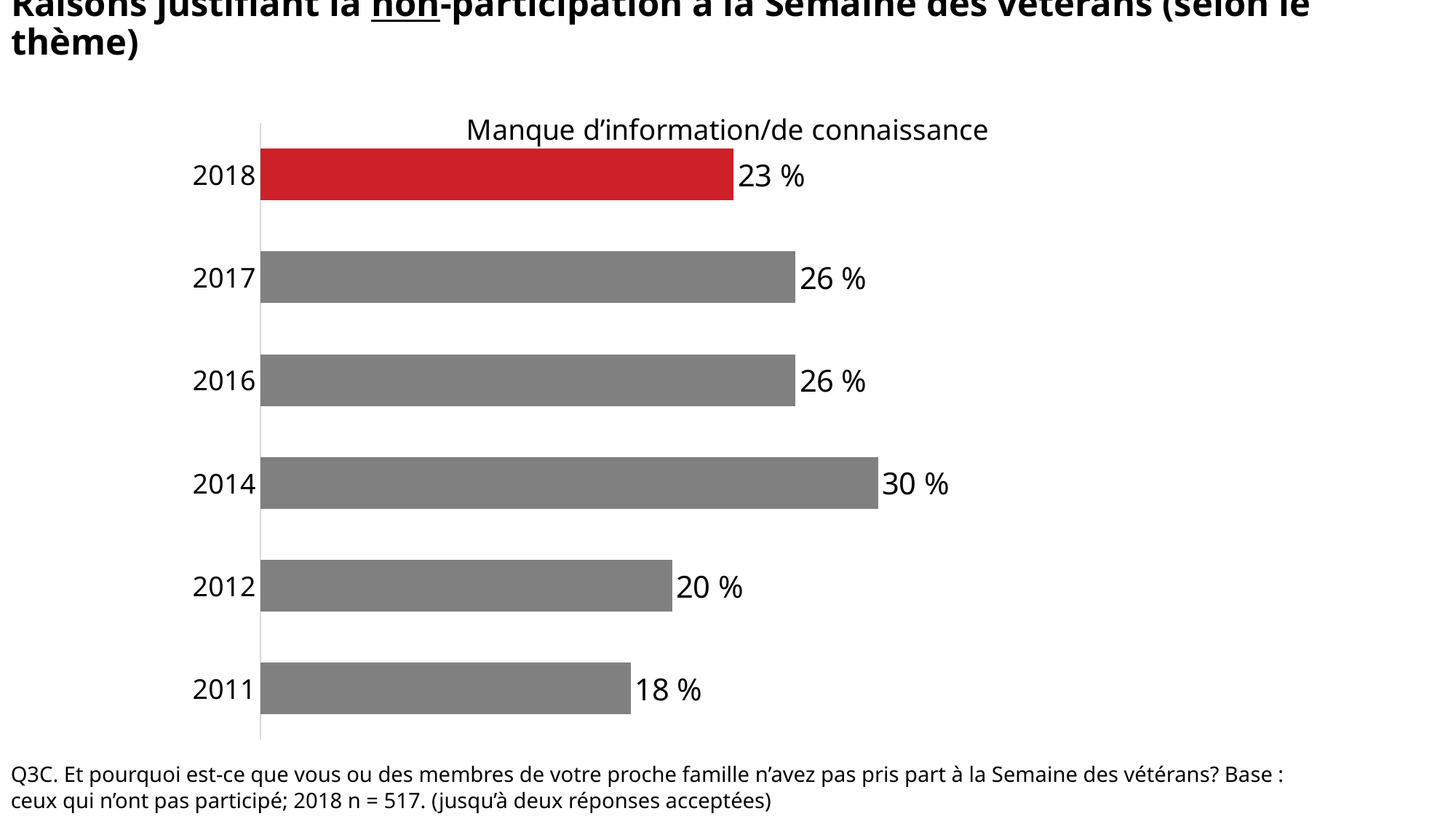
What kind of chart is shown on the slide? Bar chart What is the value for 2018 in the chart? 23 % What is the difference between the values for 2017 and 2018? 3 % Which is larger, the value for 2018 or the value for 2012? 2018 Which year has the lowest value in the chart? 2011 What is the difference between the values for 2014 and 2011? 12 % What is the value for 2012 in the chart? 20 % Which year has the highest value in the chart? 2014 What is the value for 2011 in the chart? 18 % What is the title of the chart? Manque d’information/de connaissance What is the value for 2014 in the chart? 30 % How many years are shown in the chart? 6